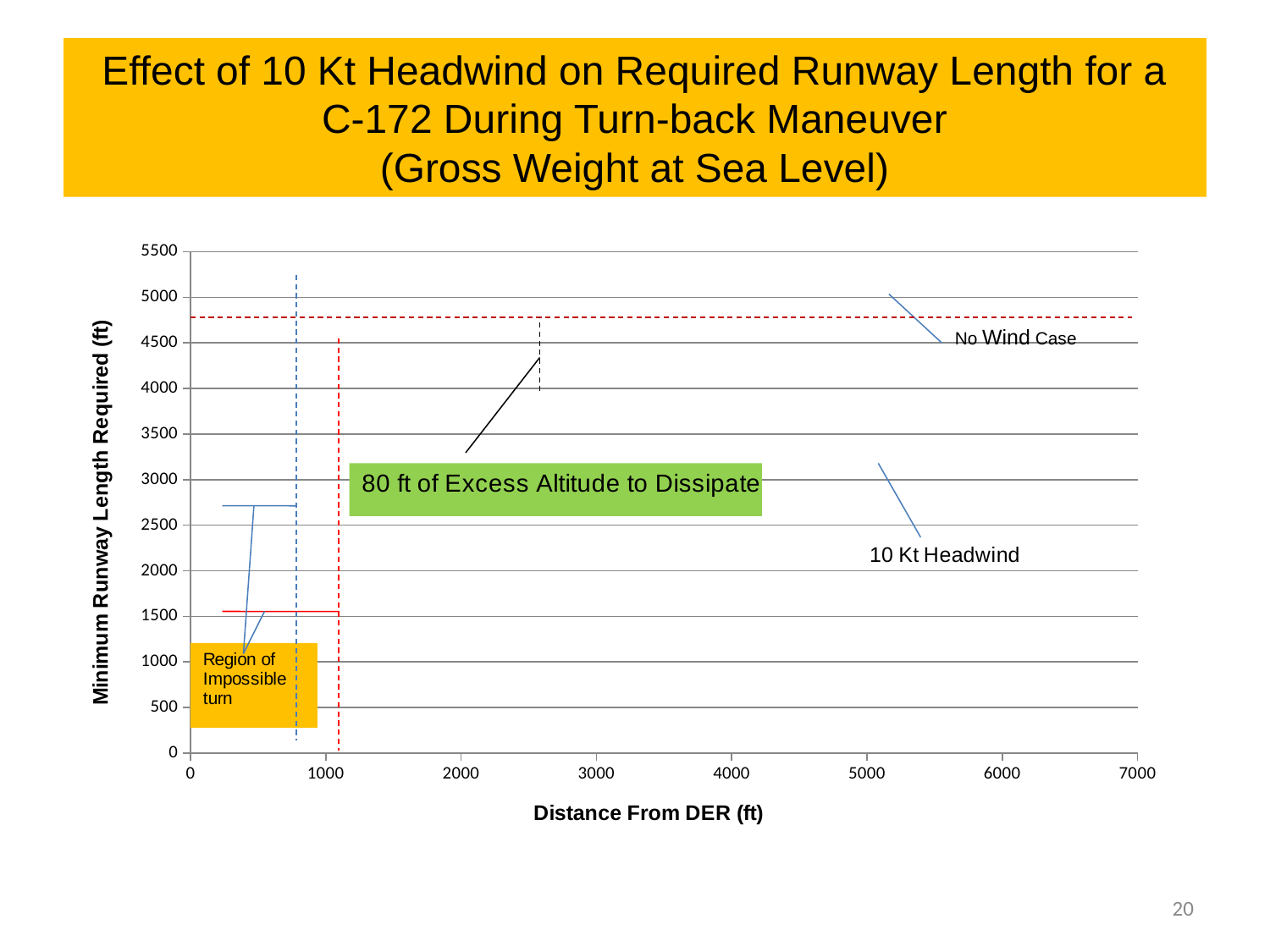
Does the No Wind Case line rise, fall, or stay flat as Distance From DER increases? stay flat What is the highest value shown on the x axis? 7000 Which case requires a longer minimum runway length, the No Wind Case or the 10 Kt Headwind case? No Wind Case Is the Minimum Runway Length Required for the No Wind Case greater or less than 4500? greater Is the Minimum Runway Length Required for the No Wind Case greater or less than 5000? less What is the title of the x axis? Distance From DER (ft) What is the title of the y axis? Minimum Runway Length Required (ft) What kind of chart is shown on the slide? line chart